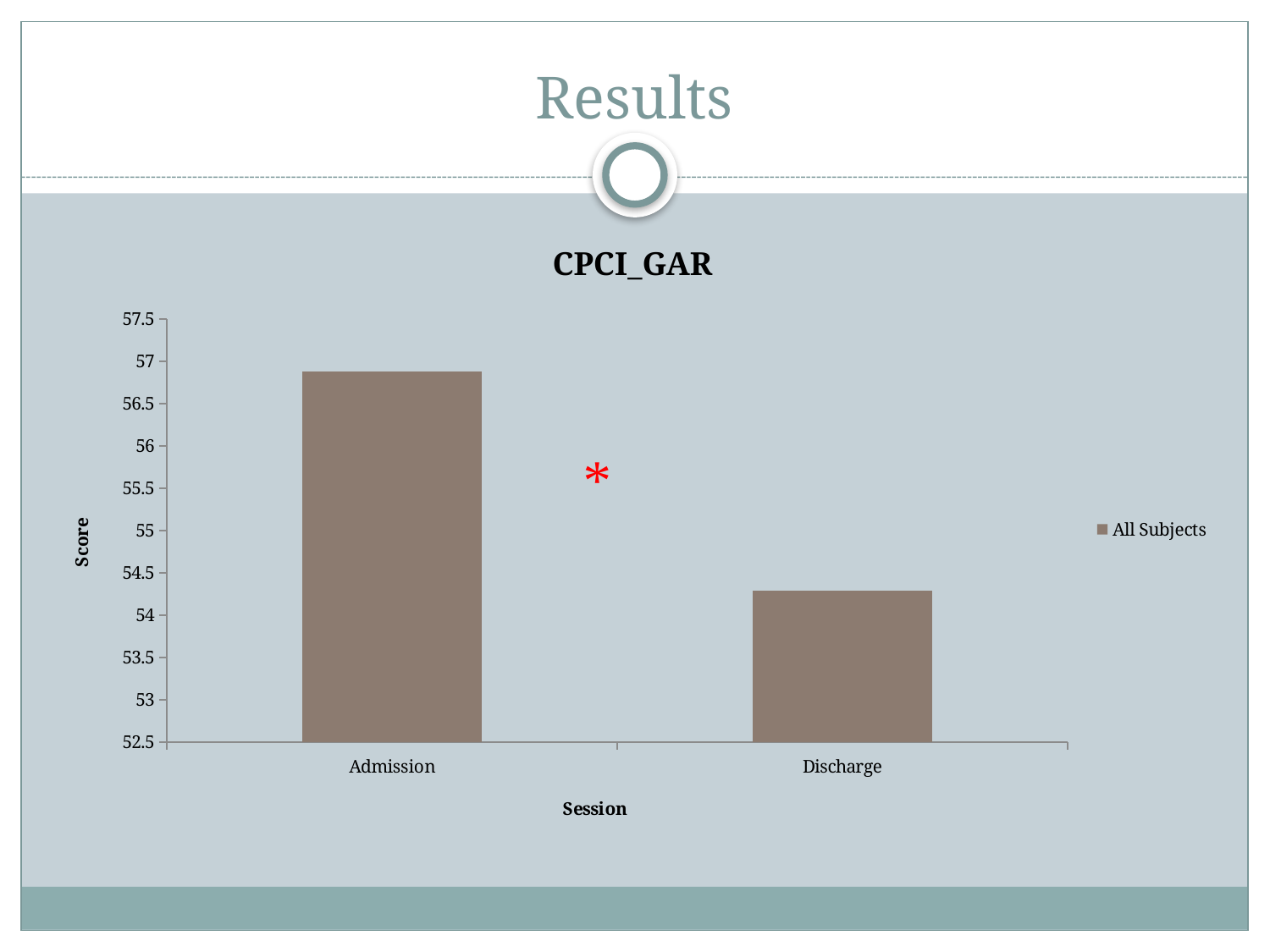
Do the values rise or fall from Admission to Discharge? fall Which is larger, the score for Admission or the score for Discharge? Admission Is the value for Admission greater or less than 56.5? greater How many categories are shown on the x axis? 2 Which session has the highest score? Admission What type of chart is shown on the slide? bar chart What is the title of the chart? CPCI_GAR Is the value for Discharge greater or less than 54.5? less What series name appears in the legend? All Subjects Is the value for Admission greater or less than 57? less How many series does the legend list? 1 Which session has the lowest score? Discharge